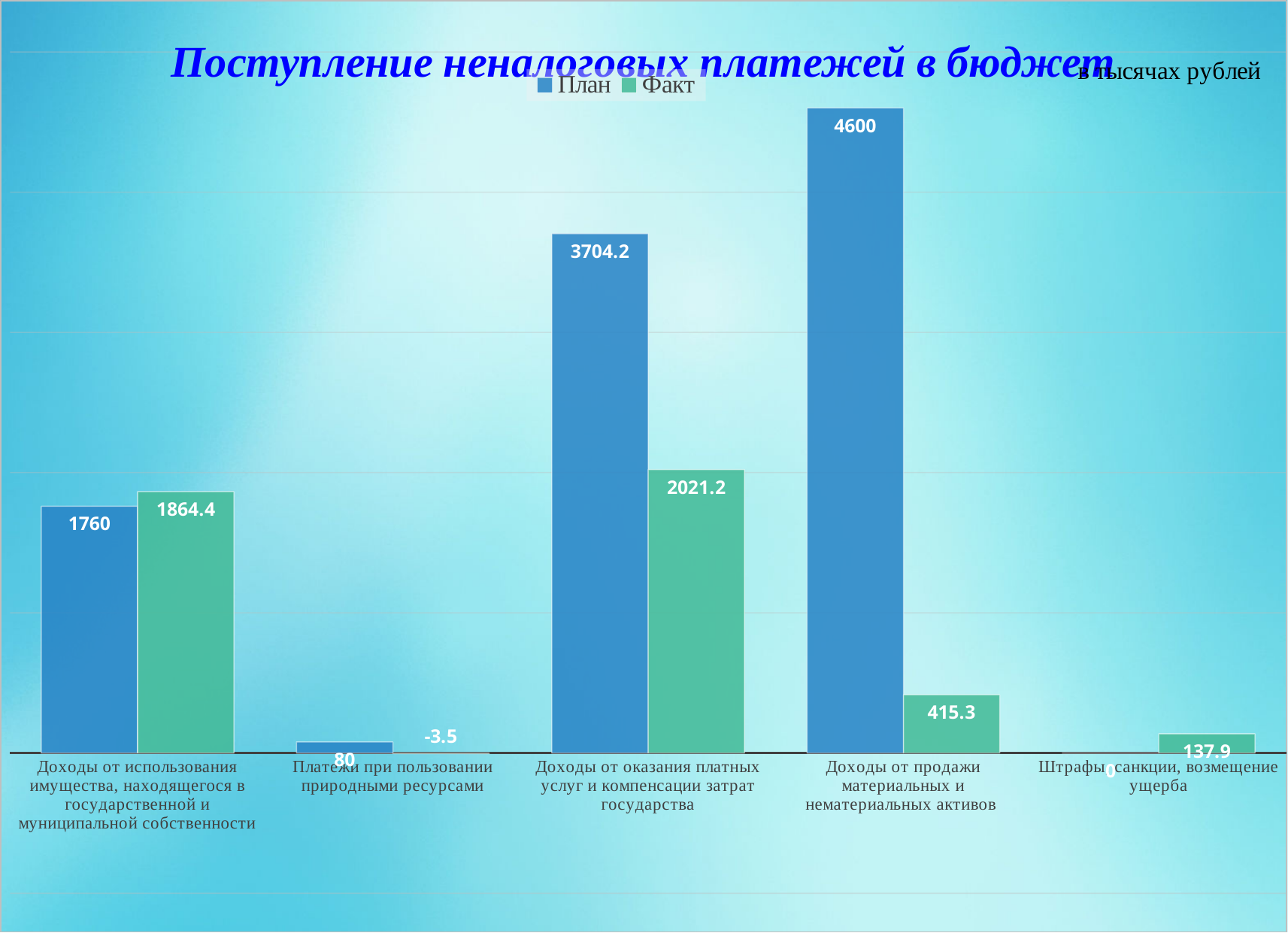
What is the План value for Доходы от продажи материальных и нематериальных активов? 4600 How many series does the legend list? 2 What is the title of the chart? Поступление неналоговых платежей в бюджет For Доходы от использования имущества, находящегося в государственной и муниципальной собственности, which is larger: План or Факт? Факт What kind of chart is shown on the slide? Bar chart Which category has the highest План value? Доходы от продажи материальных и нематериальных активов What is the difference between the План and Факт values for Доходы от продажи материальных и нематериальных активов? 4184.7 How many categories are shown on the x axis? 5 Which category has the lowest Факт value? Платежи при пользовании природными ресурсами What is the Факт value for Доходы от оказания платных услуг и компенсации затрат государства? 2021.2 What is the Факт value for Платежи при пользовании природными ресурсами? -3.5 What is the План value for Штрафы, санкции, возмещение ущерба? 0